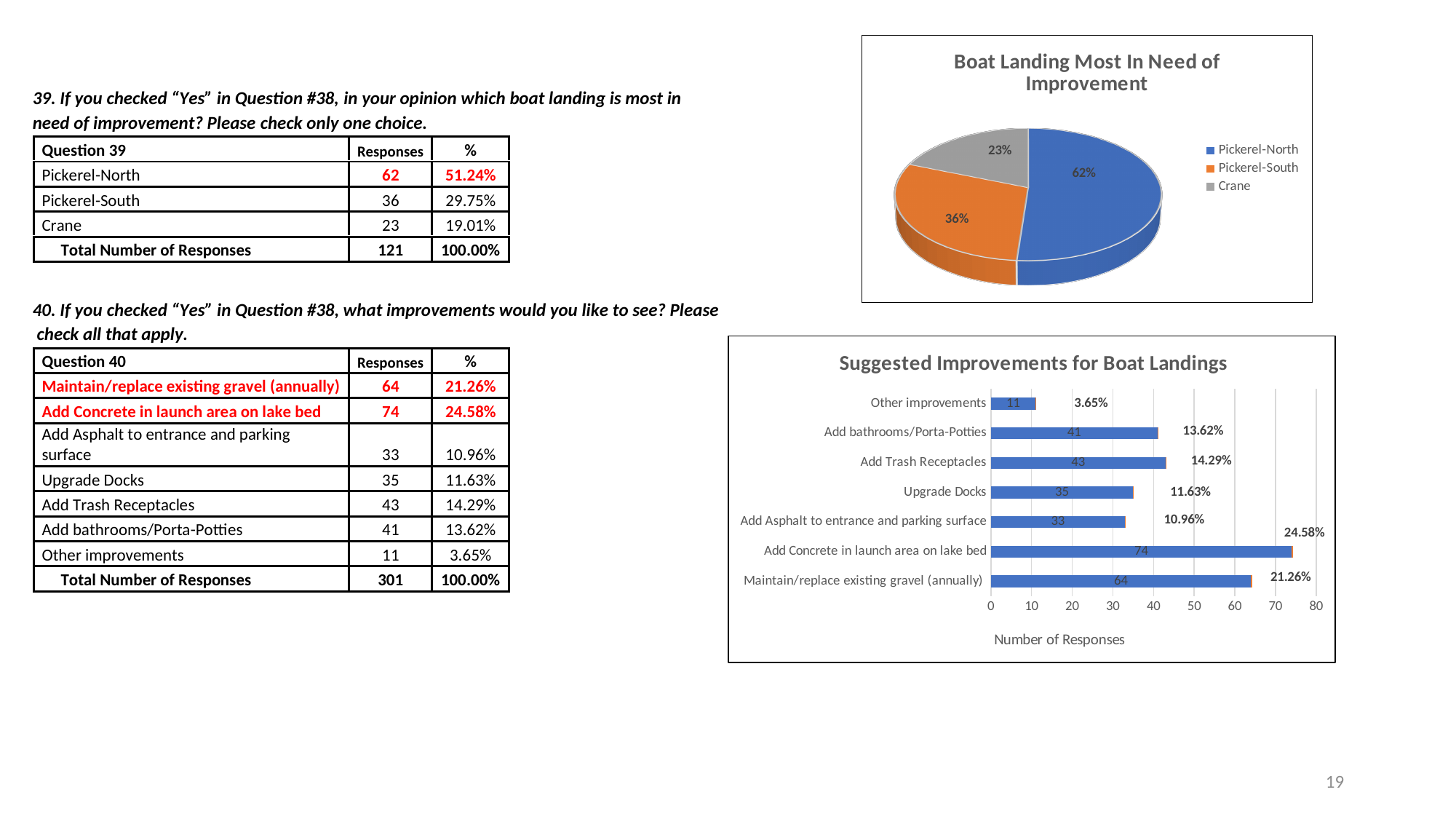
In the 'Suggested Improvements for Boat Landings' chart, which has more responses: Upgrade Docks or Add bathrooms/Porta-Potties? Add bathrooms/Porta-Potties In the 'Suggested Improvements for Boat Landings' chart, what is the difference in responses between Add Concrete in launch area on lake bed and Maintain/replace existing gravel (annually)? 10 In the 'Boat Landing Most In Need of Improvement' chart, how many entries does the legend list? 3 In the 'Boat Landing Most In Need of Improvement' chart, which boat landing has the smallest slice? Crane In the 'Suggested Improvements for Boat Landings' chart, what kind of chart is shown? bar chart In the 'Suggested Improvements for Boat Landings' chart, which improvement has the most responses? Add Concrete in launch area on lake bed In the 'Suggested Improvements for Boat Landings' chart, how many improvement categories are plotted? 7 In the 'Boat Landing Most In Need of Improvement' chart, what percentage is shown for Pickerel-South? 36% In the 'Boat Landing Most In Need of Improvement' chart, what kind of chart is shown? pie chart In the 'Boat Landing Most In Need of Improvement' chart, which boat landing has the largest slice? Pickerel-North In the 'Suggested Improvements for Boat Landings' chart, which improvement has the fewest responses? Other improvements In the 'Suggested Improvements for Boat Landings' chart, how many responses are shown for Add Trash Receptacles? 43